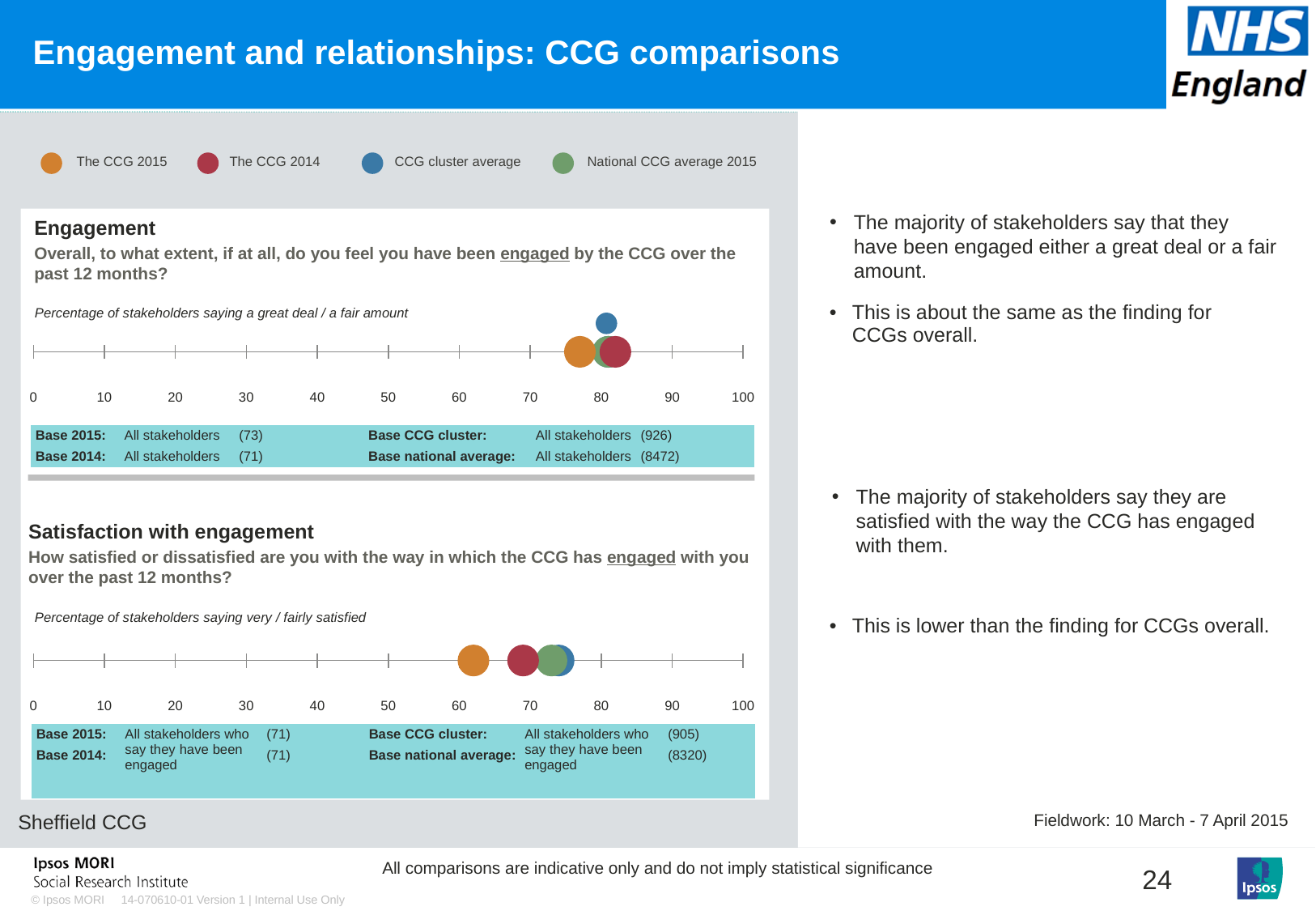
On the Engagement chart, is the value for The CCG 2015 greater or less than 70? greater What is the highest value shown on the axis of the Engagement chart? 100 On the Engagement chart, which is larger: The CCG 2015 or The CCG 2014? The CCG 2014 Which colour represents the CCG cluster average in the legend? Blue On the Engagement chart, is the value for The CCG 2014 greater or less than 90? less On the Satisfaction with engagement chart, which series has the lowest value? The CCG 2015 On the Satisfaction with engagement chart, is the value for The CCG 2015 greater or less than 70? less How many series does the legend list? 4 What kind of chart is used to show the Engagement results? Dot plot on a 0-100 scale On the Satisfaction with engagement chart, which is larger: The CCG 2015 or the National CCG average 2015? National CCG average 2015